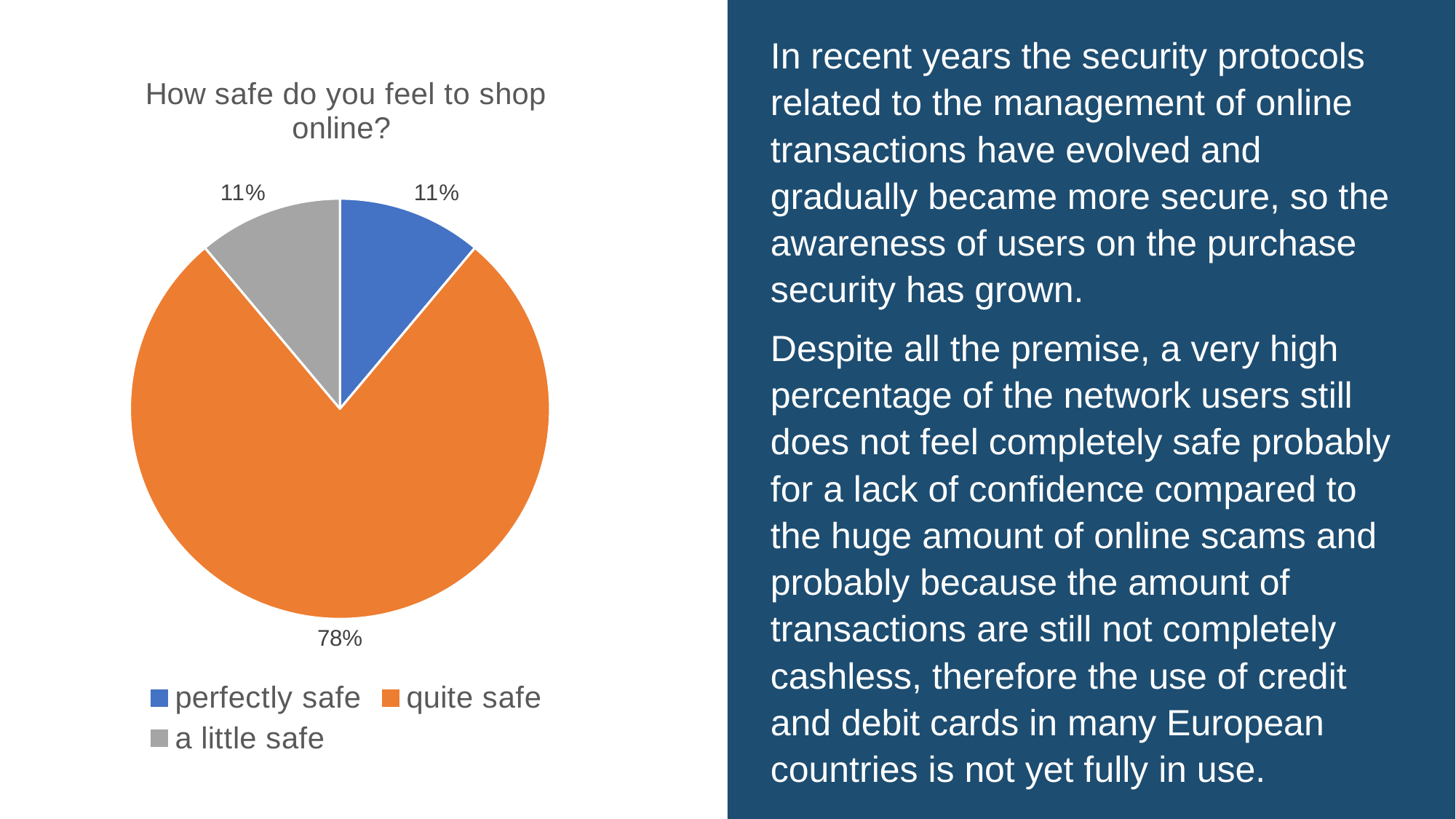
What is the title of the chart? How safe do you feel to shop online? What is the combined share of perfectly safe and a little safe? 22% What percentage of respondents feel quite safe shopping online? 78% How many categories does the legend list? 3 What kind of chart is shown on the slide? pie chart What percentage of respondents feel a little safe shopping online? 11% Which colour represents the quite safe category? orange What percentage of respondents feel perfectly safe shopping online? 11% Which is larger, the share for quite safe or the share for a little safe? quite safe What is the difference between the share for quite safe and the share for perfectly safe? 67% Which category has the largest share of the pie? quite safe